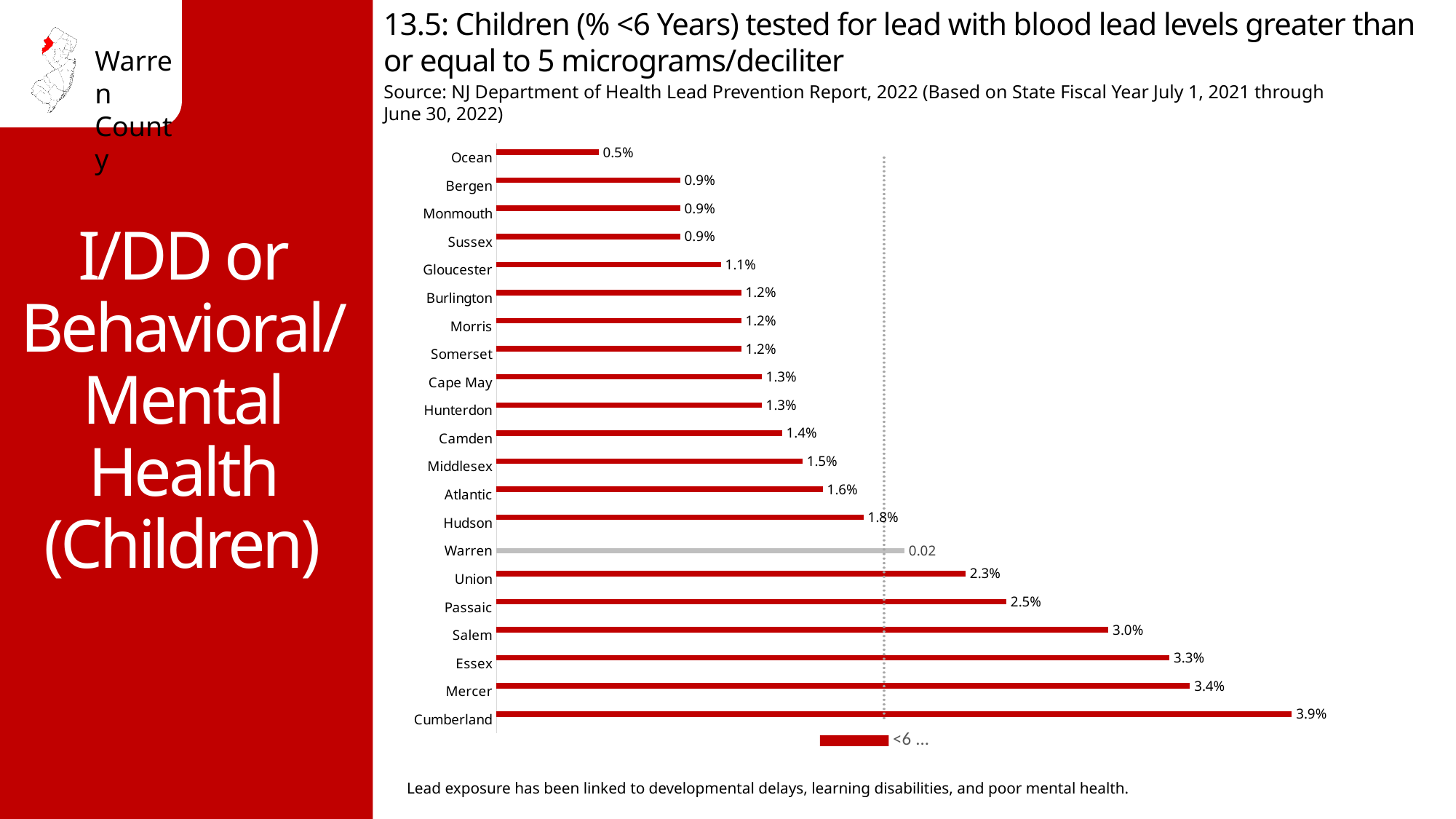
What is the difference between the values for Essex and Salem? 0.3% What is the value shown for Salem? 3.0% What is the value shown for Camden? 1.4% What is the difference between the values for Cumberland and Mercer? 0.5% Which county has the lowest percentage in the chart? Ocean What colour is the bar for Warren, which differs from the other bars? grey How many counties are plotted in the chart? 21 Which county has a larger value, Passaic or Union? Passaic What is the data label shown for Warren? 0.02 Which county has the highest percentage of children with blood lead levels greater than or equal to 5 micrograms/deciliter? Cumberland What type of chart is shown on the slide? bar chart What is the value shown for Cumberland? 3.9%